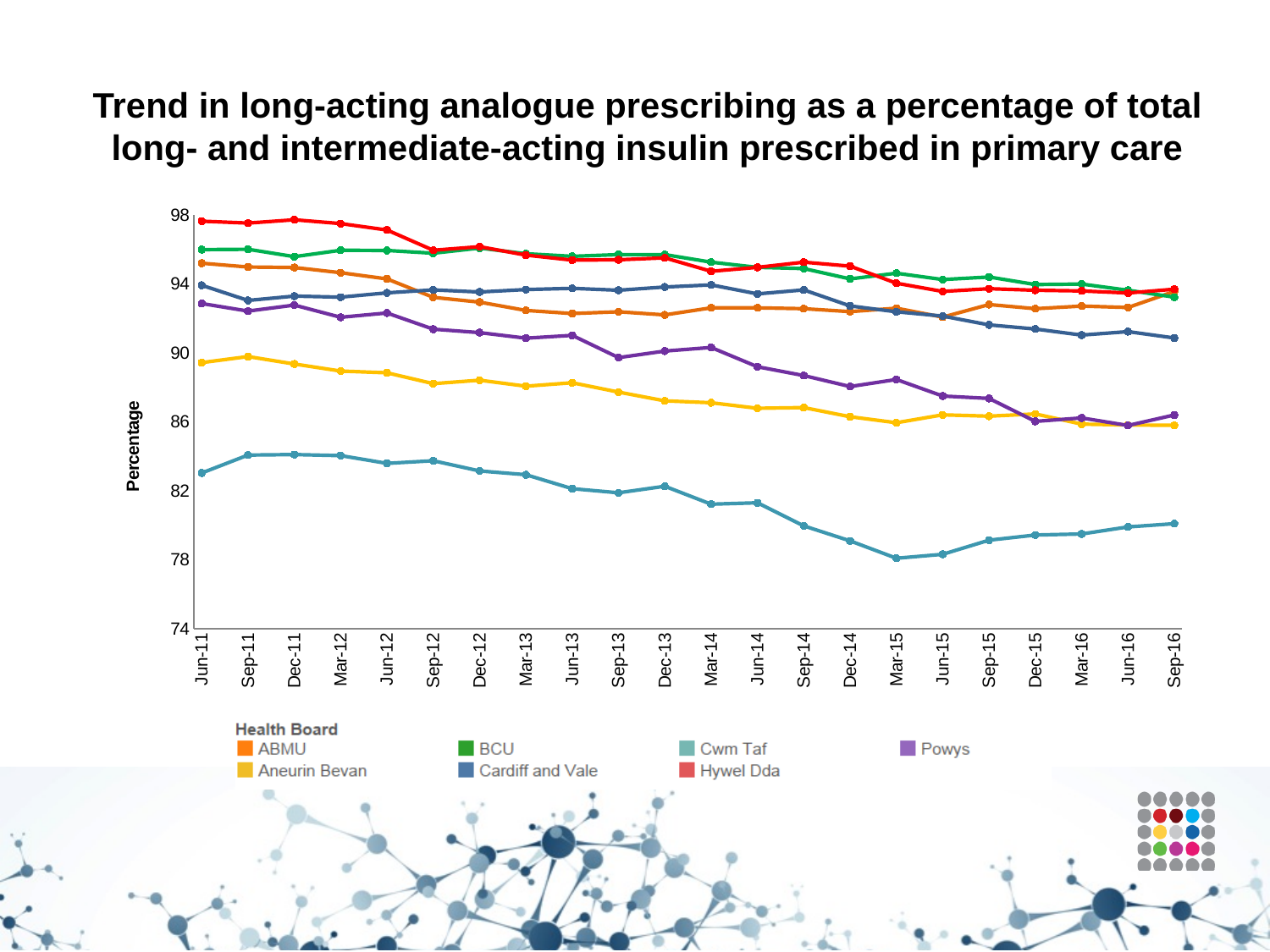
How many time points are shown along the x axis? 22 At Jun-11, which is larger: the value for Aneurin Bevan or the value for Cwm Taf? Aneurin Bevan What is the label on the y axis? Percentage Is the value for Cwm Taf at Mar-15 greater or less than 82? less Is the value for Aneurin Bevan at Jun-11 greater or less than 90? less Is the value for Cwm Taf at Jun-11 greater or less than 86? less Which health board has the lowest percentage across the whole period? Cwm Taf Which health board has the highest percentage at Jun-11? Hywel Dda Does the Cwm Taf line generally rise or fall from Jun-11 to Sep-16? Fall How many health boards does the legend list? 7 What kind of chart is shown on the slide? Line chart